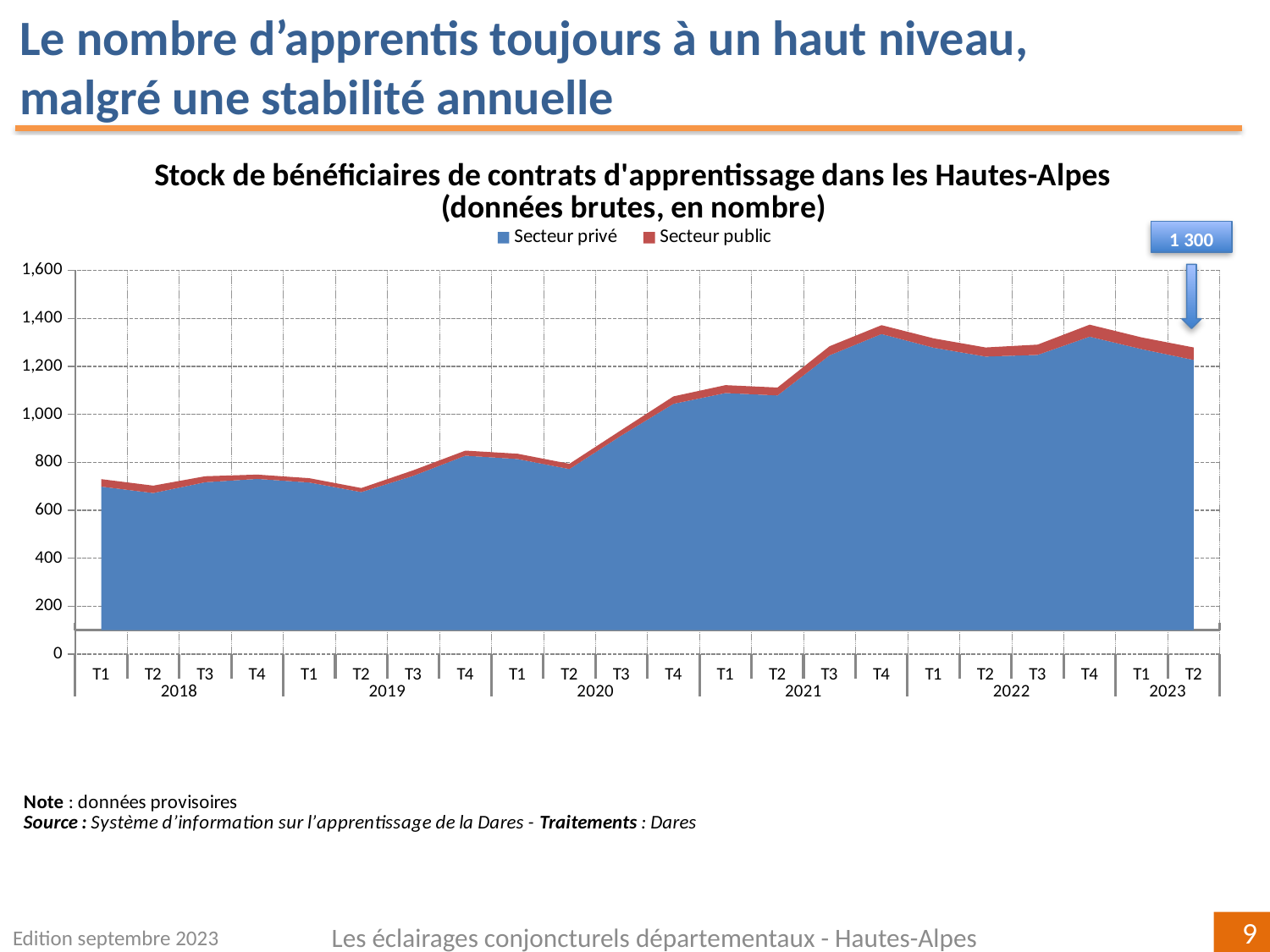
How many series does the legend list? 2 What are the two series named in the legend? Secteur privé and Secteur public Is the total stock in T1 2018 greater or less than 600? greater Is the total stock in T2 2023 greater or less than 1,400? less How many quarterly points are plotted along the x axis, from T1 2018 to T2 2023? 22 Which is larger, the total stock in T1 2018 or in T1 2021? T1 2021 Is the total stock in T2 2019 greater or less than 800? less What value does the callout box pointing to T2 2023 show? 1 300 What type of chart is shown on the slide? Stacked area chart Which series accounts for the larger share of the stock, Secteur privé or Secteur public? Secteur privé